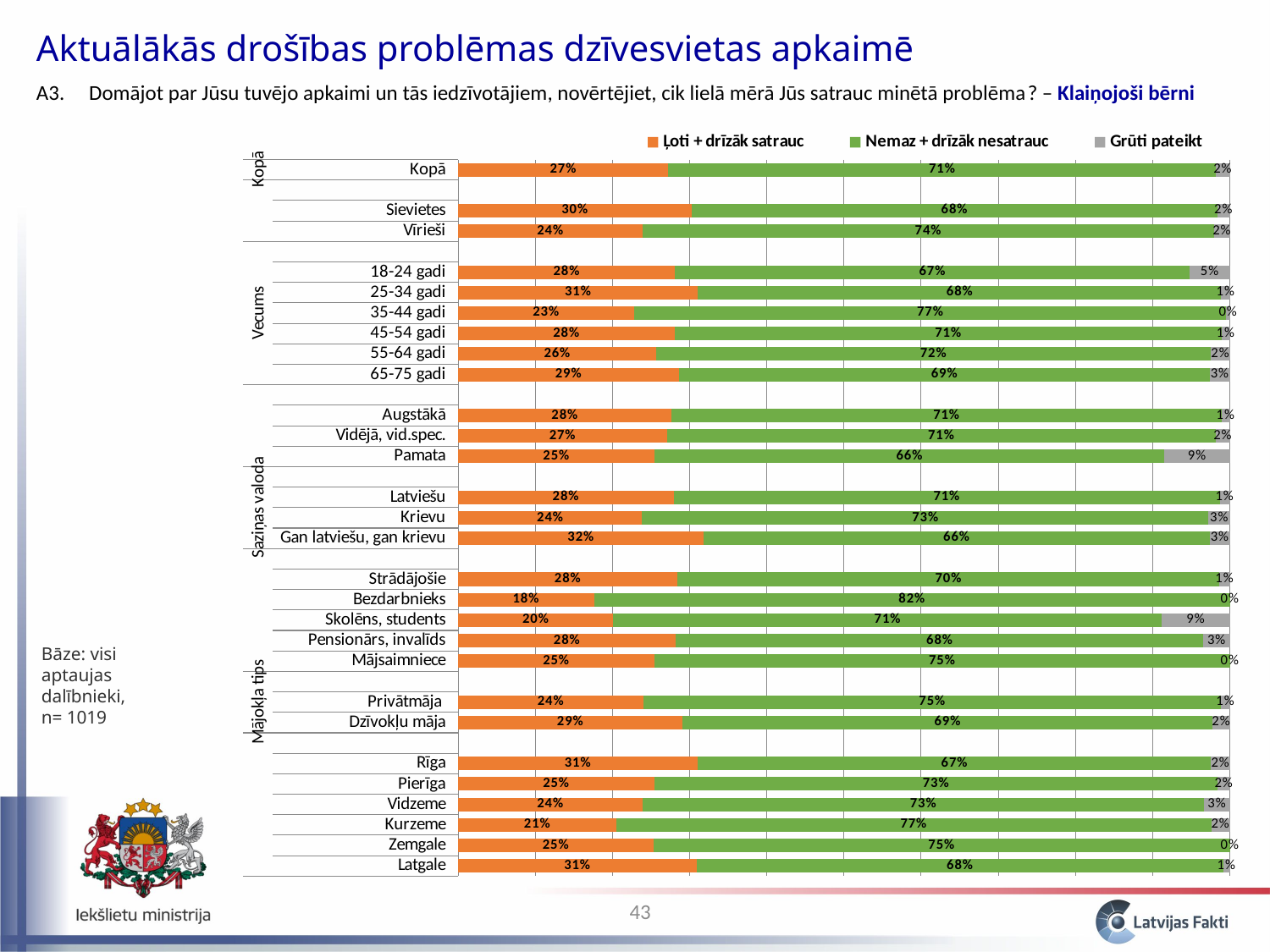
What percentage of all respondents (Kopā) answered "Ļoti + drīzāk satrauc"? 27% What is the difference in percentage points between the "Ļoti + drīzāk satrauc" values for Sievietes and Vīrieši? 6 percentage points What is the total of the three segments of the Kopā bar? 100% What colour represents "Grūti pateikt" in the legend? Grey Which category has the highest "Ļoti + drīzāk satrauc" value? Gan latviešu, gan krievu What is the "Nemaz + drīzāk nesatrauc" value for Bezdarbnieks? 82% What kind of chart is shown on the slide? Stacked bar chart How many categories (bars) are shown in the chart? 28 Which has a larger "Ļoti + drīzāk satrauc" value, Rīga or Pierīga? Rīga Which category has the lowest "Ļoti + drīzāk satrauc" value? Bezdarbnieks What is the "Grūti pateikt" value for the Pamata group? 9% How many series does the legend list? 3